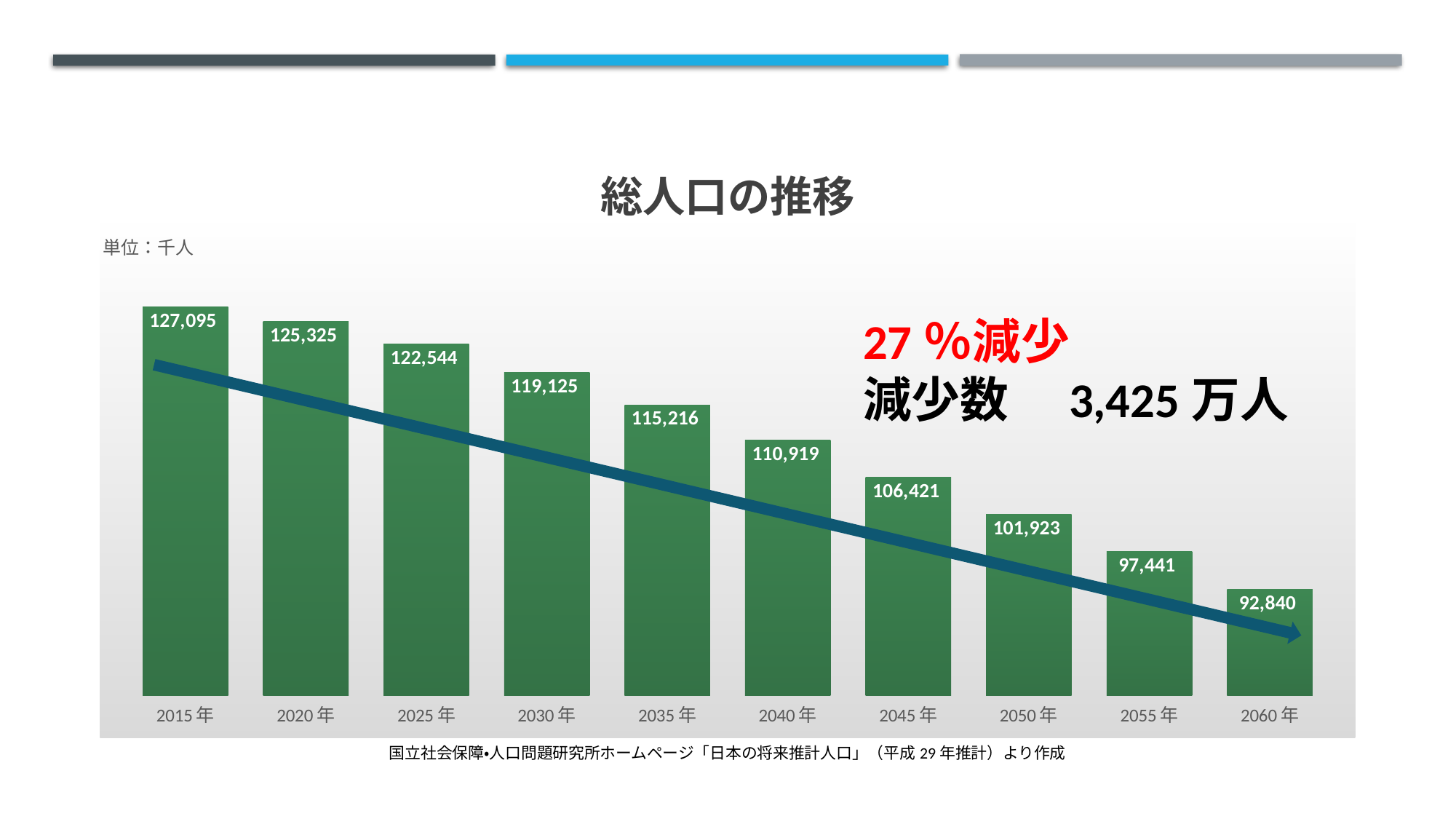
What is the value for 2040年? 110,919 Do the values rise or fall from 2015年 to 2060年? fall What is the value for 2060年? 92,840 How many years are shown on the x axis? 10 Which is larger, the value for 2045年 or the value for 2050年? 2045年 What is the difference between the values for 2015年 and 2060年? 34,255 What kind of chart is this? bar chart What is the value for 2015年? 127,095 Which year has the lowest value? 2060年 Which year has the highest value? 2015年 What is the title of the chart? 総人口の推移 What is the difference between the values for 2030年 and 2035年? 3,909